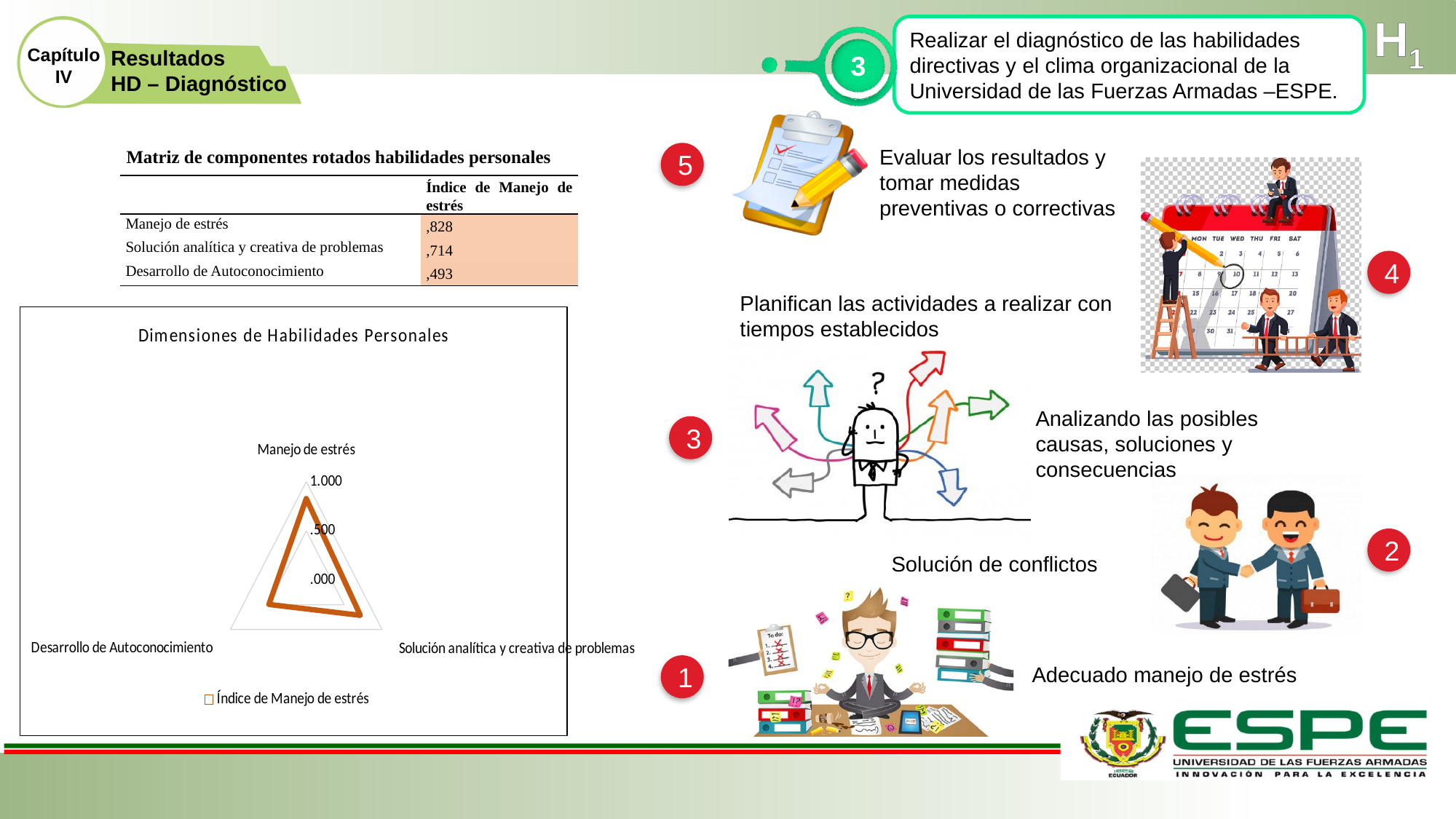
What is the title of the radar chart on the slide? Dimensiones de Habilidades Personales What kind of chart is shown under the title "Dimensiones de Habilidades Personales"? Radar chart On the "Dimensiones de Habilidades Personales" chart, which is larger: the value for Manejo de estrés or the value for Desarrollo de Autoconocimiento? Manejo de estrés How many series does the legend of the "Dimensiones de Habilidades Personales" chart list? 1 On the "Dimensiones de Habilidades Personales" chart, is the value for Manejo de estrés greater or less than .500? greater What is the highest axis tick value shown on the "Dimensiones de Habilidades Personales" radar chart? 1.000 On the "Dimensiones de Habilidades Personales" chart, is the value for Solución analítica y creativa de problemas greater or less than .500? greater Which category has the highest value on the "Dimensiones de Habilidades Personales" chart? Manejo de estrés Which category has the lowest value on the "Dimensiones de Habilidades Personales" chart? Desarrollo de Autoconocimiento On the "Dimensiones de Habilidades Personales" chart, is the value for Manejo de estrés greater or less than 1.000? less How many categories are plotted on the "Dimensiones de Habilidades Personales" radar chart? 3 What is the name of the series shown in the legend of the "Dimensiones de Habilidades Personales" chart? Índice de Manejo de estrés